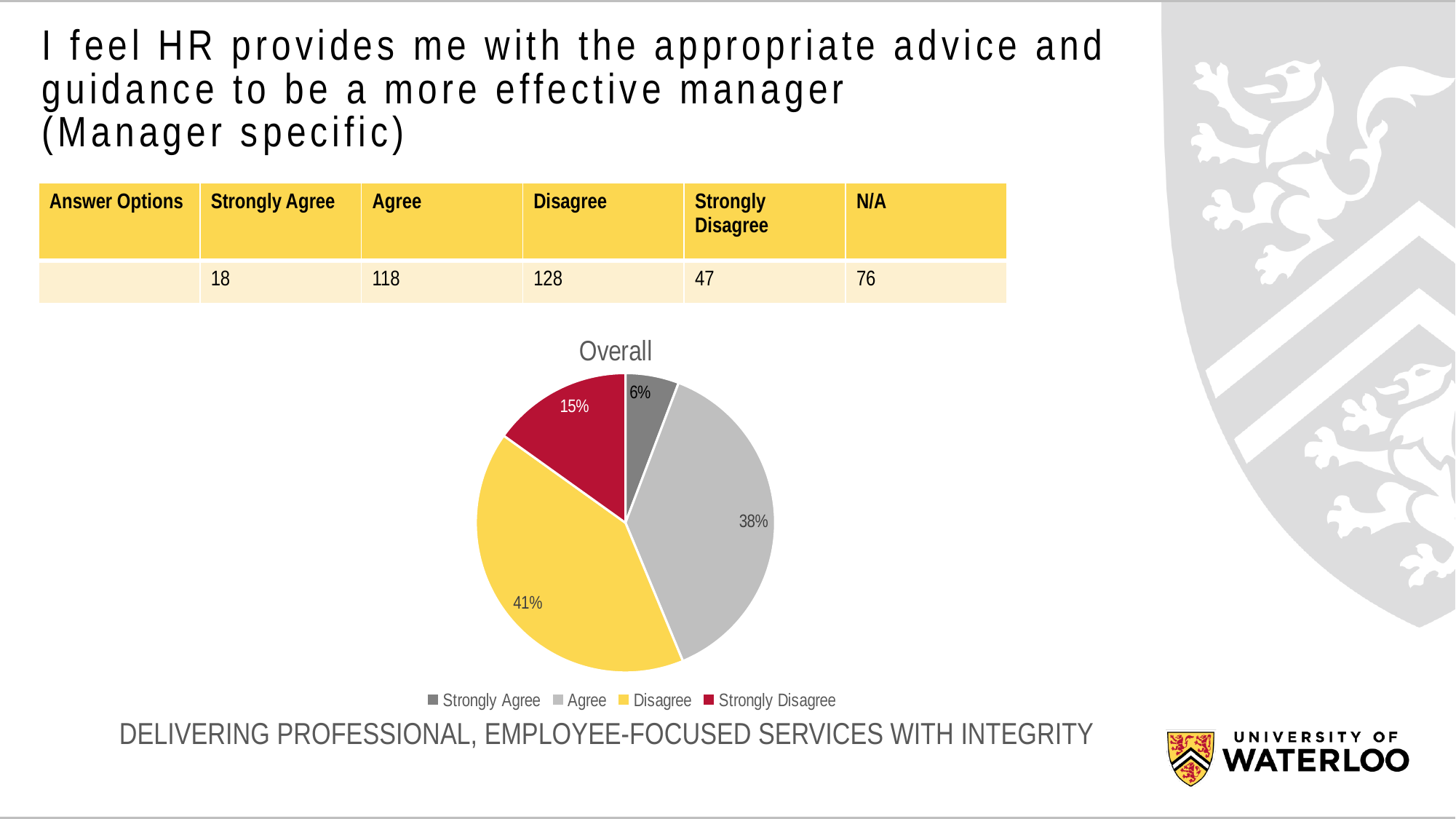
How many slices does the pie chart have? 4 What kind of chart is shown on the slide? pie chart What share of the pie does Disagree take? 41% Which category has the largest slice of the pie? Disagree How many entries does the legend list? 4 Which slice is larger, Strongly Disagree or Strongly Agree? Strongly Disagree What is the chart's title? Overall What share of the pie does Strongly Agree take? 6% What share of the pie does Agree take? 38% What is the difference in percentage points between the Disagree and Agree slices? 3 Which category has the smallest slice of the pie? Strongly Agree